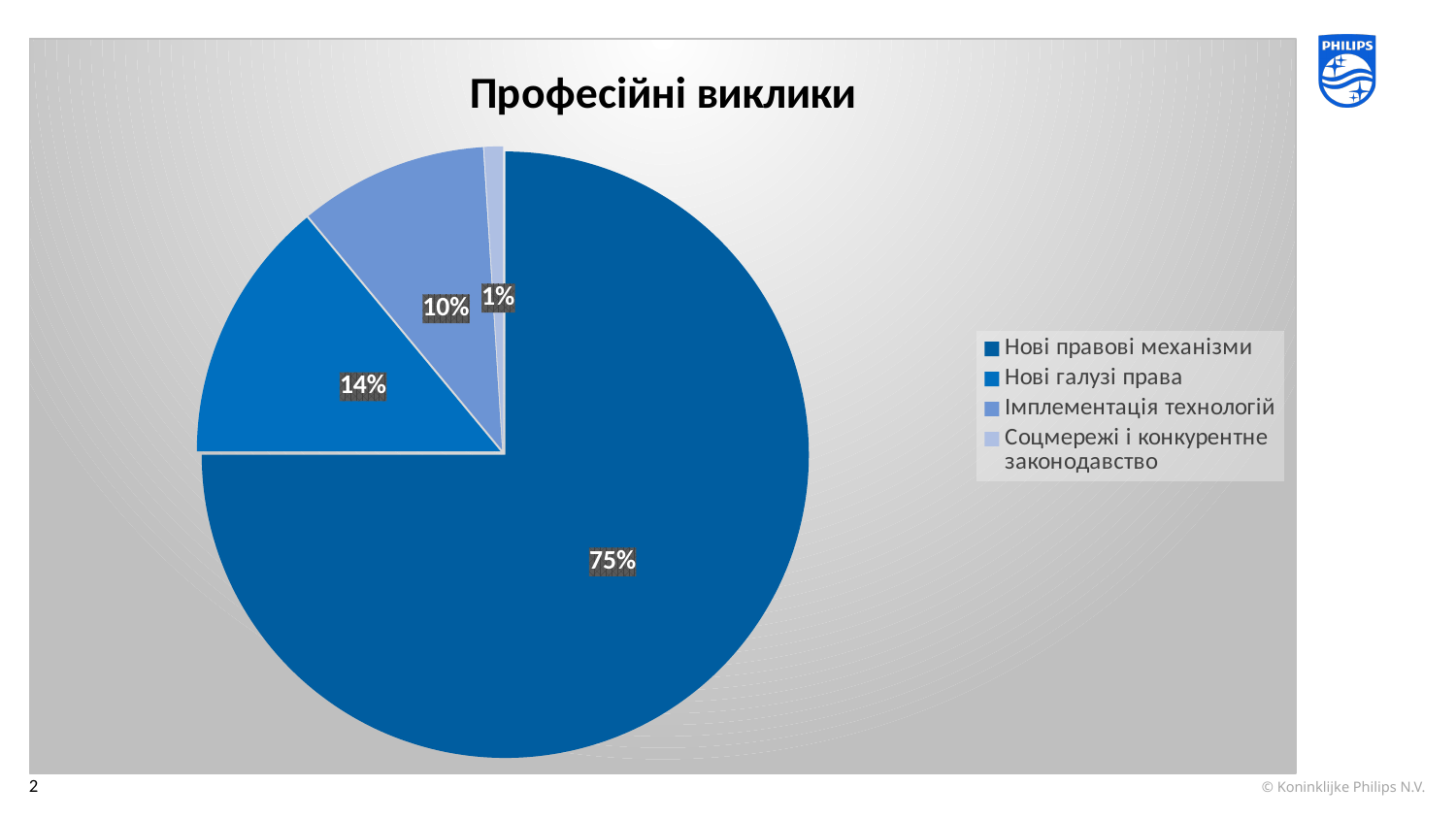
What is the value for "Імплементація технологій"? 10% What kind of chart is shown on the slide? Pie chart What is the difference between the largest and the smallest slice? 74% What is the value for "Нові галузі права"? 14% What is the difference between the shares of "Нові галузі права" and "Імплементація технологій"? 4% What is the value for "Соцмережі і конкурентне законодавство"? 1% Which is larger, the share for "Нові галузі права" or the share for "Імплементація технологій"? Нові галузі права What share of the pie does "Нові правові механізми" take? 75% Which category has the largest slice of the pie? Нові правові механізми What is the title of the chart? Професійні виклики How many categories does the pie chart show? 4 Which category has the smallest slice of the pie? Соцмережі і конкурентне законодавство